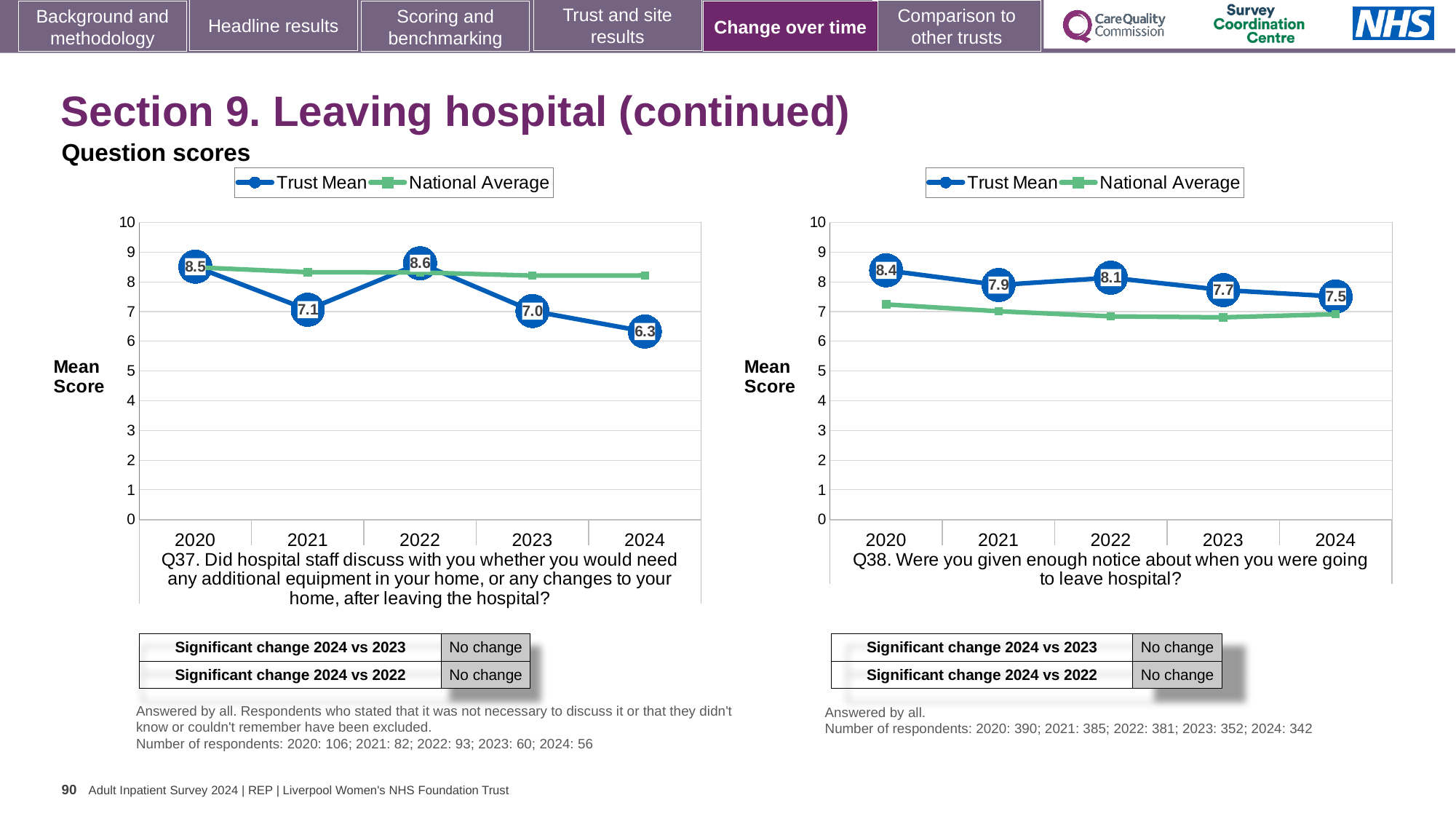
In the Q38 chart on the right, which year has the highest Trust Mean score? 2020 In the Q37 chart on the left, which year has the lowest Trust Mean score? 2024 How many series does the legend of the Q37 chart on the left list? 2 In the Q37 chart on the left, what is the difference between the Trust Mean scores for 2022 and 2024? 2.3 In the Q38 chart on the right, is the National Average for 2022 greater or less than 7? less In the Q38 chart on the right, which is larger in 2021: the Trust Mean or the National Average? Trust Mean In the Q38 chart on the right, what is the difference between the Trust Mean scores for 2020 and 2024? 0.9 In the Q37 chart on the left, is the National Average for 2024 greater or less than 8? greater In the Q38 chart on the right, what is the Trust Mean score for 2020? 8.4 In the Q38 chart on the right, what is the Trust Mean score for 2023? 7.7 In the Q37 chart on the left, what is the Trust Mean score for 2022? 8.6 In the Q37 chart on the left, what is the Trust Mean score for 2024? 6.3